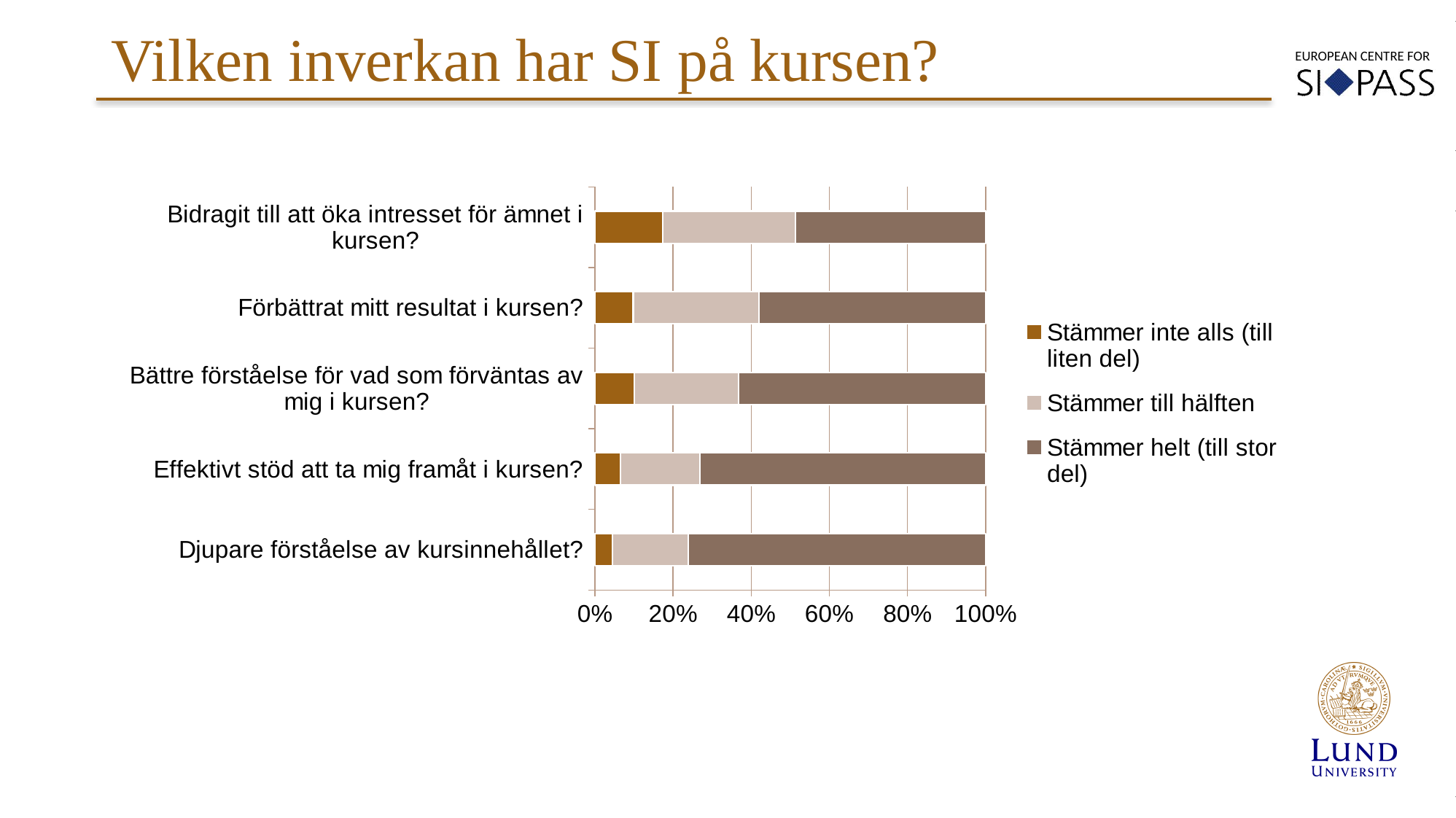
What is the title of the slide containing the chart? Vilken inverkan har SI på kursen? What does each stacked bar total on the x axis? 100% Which category has the smallest 'Stämmer helt (till stor del)' segment? Bidragit till att öka intresset för ämnet i kursen? Which has the larger 'Stämmer till hälften' share: 'Bidragit till att öka intresset för ämnet i kursen?' or 'Djupare förståelse av kursinnehållet?'? Bidragit till att öka intresset för ämnet i kursen? Is the 'Stämmer helt (till stor del)' share for 'Bidragit till att öka intresset för ämnet i kursen?' greater or less than 60%? less How many series does the legend list? 3 Is the 'Stämmer helt (till stor del)' share for 'Djupare förståelse av kursinnehållet?' greater or less than 60%? greater Which has the larger 'Stämmer helt (till stor del)' share: 'Effektivt stöd att ta mig framåt i kursen?' or 'Förbättrat mitt resultat i kursen?'? Effektivt stöd att ta mig framåt i kursen? What kind of chart is shown on the slide? Stacked bar chart Which category has the largest 'Stämmer inte alls (till liten del)' segment? Bidragit till att öka intresset för ämnet i kursen? Is the 'Stämmer inte alls (till liten del)' share for 'Bidragit till att öka intresset för ämnet i kursen?' greater or less than 20%? less How many categories (survey statements) are plotted on the chart? 5